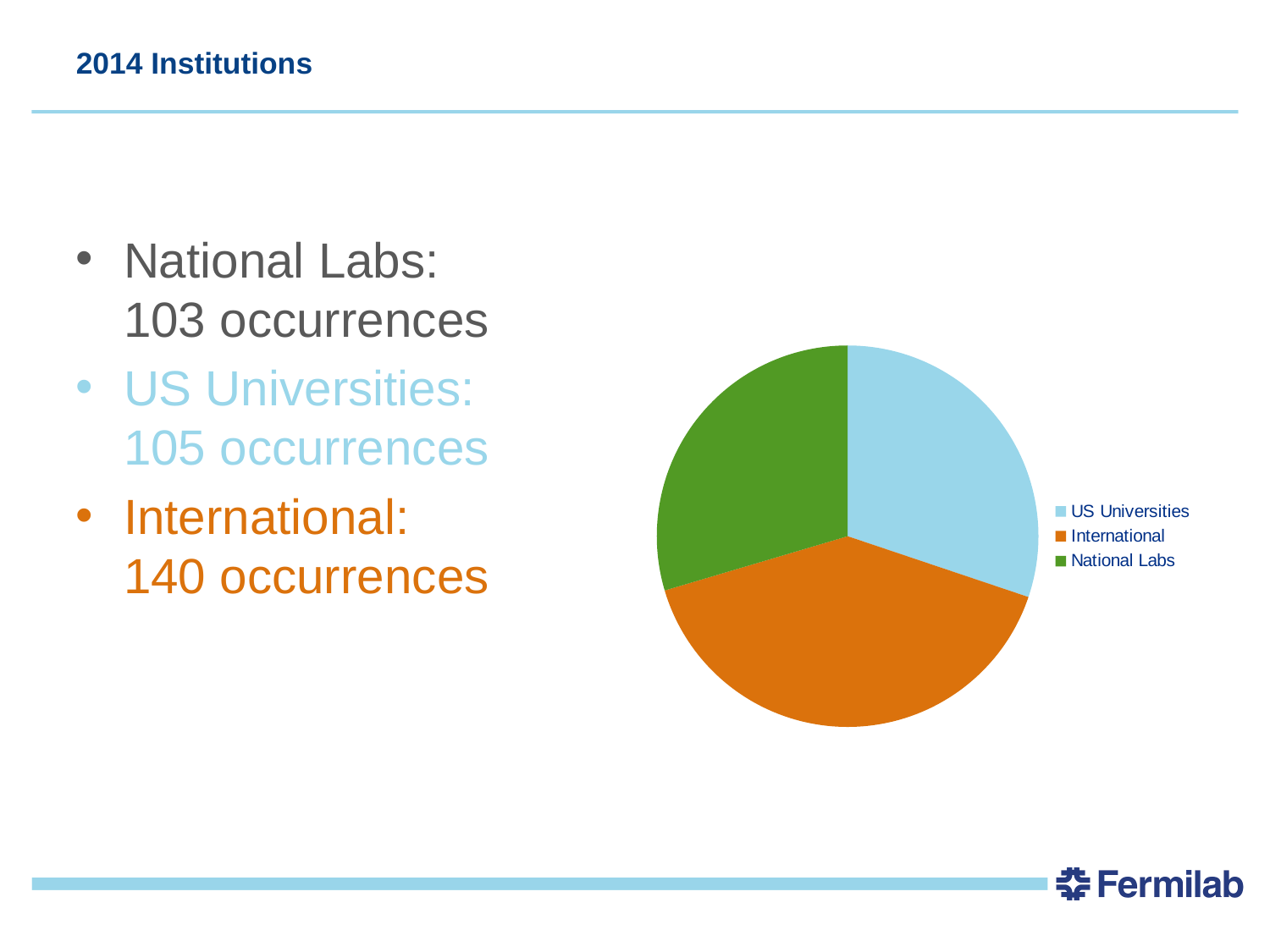
Which is larger, the slice for International or the slice for National Labs? International How many occurrences are shown for National Labs? 103 occurrences What is the difference in occurrences between International and US Universities? 35 How many entries does the legend of the pie chart list? 3 How many occurrences are shown for US Universities? 105 occurrences How many slices does the pie chart have? 3 What is the difference in occurrences between International and National Labs? 37 What is the title of the slide containing the pie chart? 2014 Institutions What kind of chart is shown on the slide? pie chart Which category has the largest slice of the pie chart? International What colour is the International slice in the pie chart? orange How many occurrences are shown for International? 140 occurrences